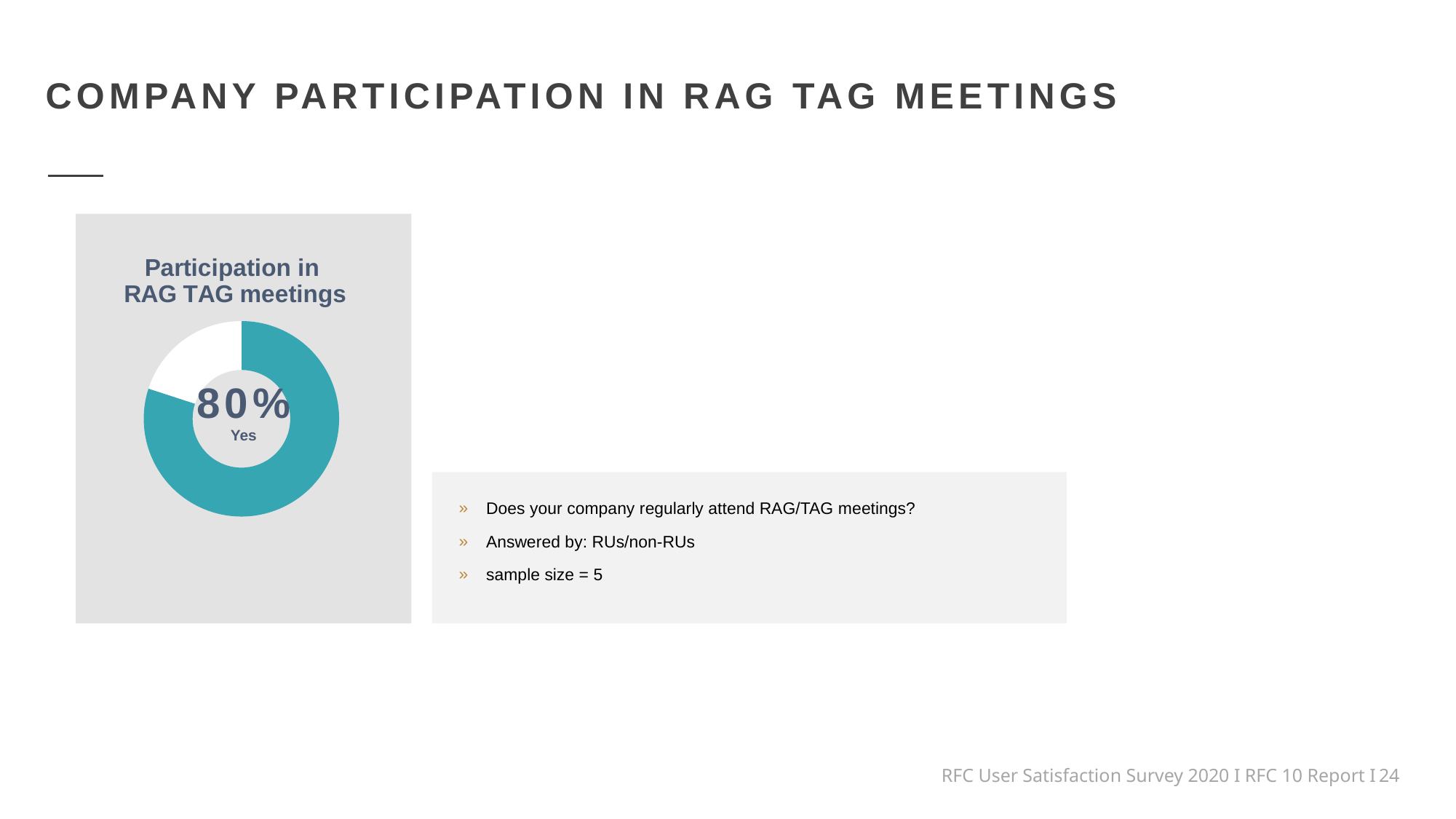
What share of the donut chart does the Yes slice represent? 80% Is the Yes slice larger or smaller than the remaining slice of the donut? larger Which slice of the donut chart is the largest? Yes What percentage of respondents answered Yes to regularly attending RAG/TAG meetings? 80% How many slices does the donut chart have? 2 What is the title of the chart? Participation in RAG TAG meetings What colour is the Yes slice of the donut chart? teal What kind of chart is shown on the slide? pie chart (donut) Is the Yes share greater or less than 50%? greater